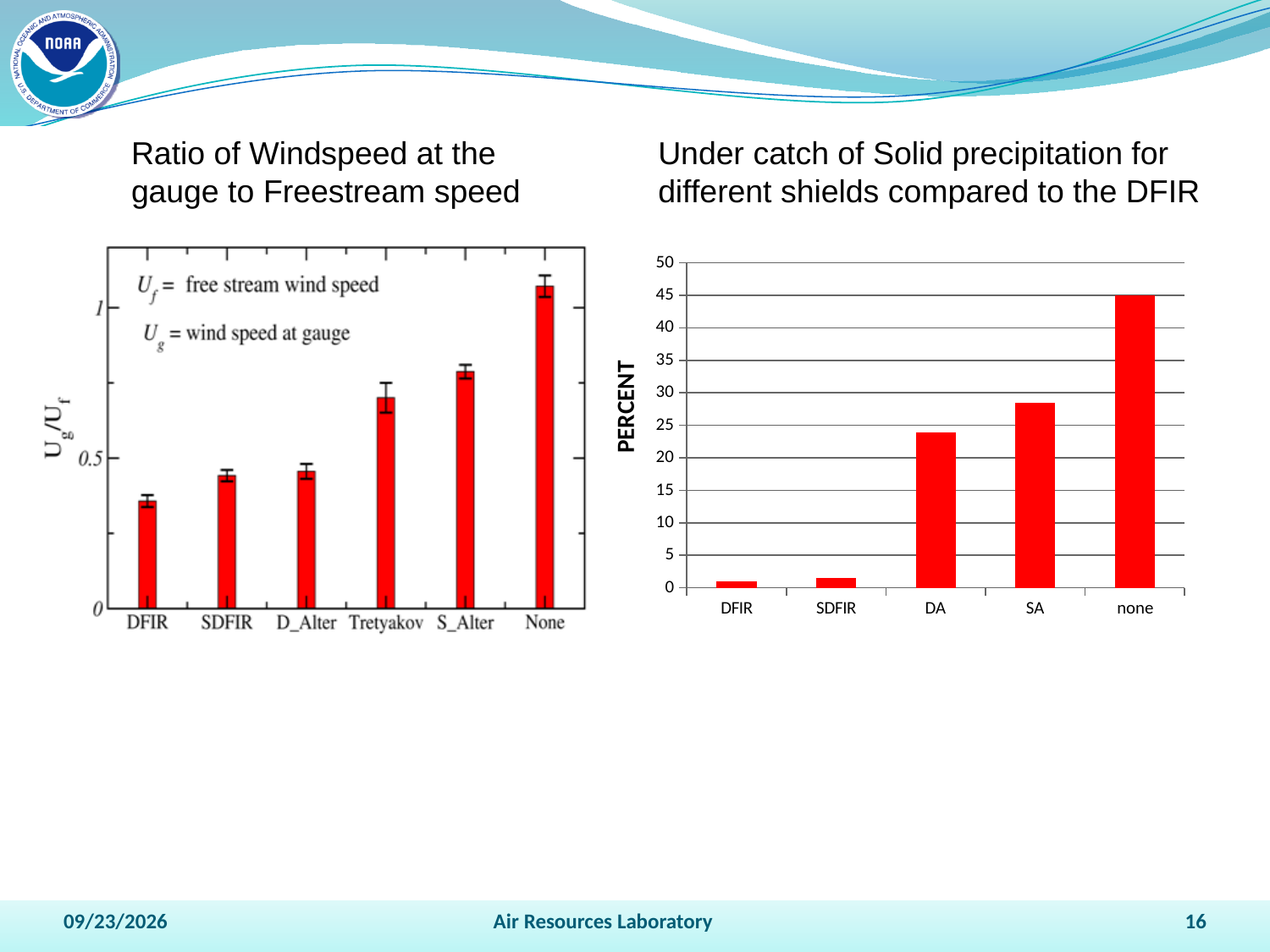
On the chart titled 'Under catch of Solid precipitation for different shields compared to the DFIR', which category has the lowest value? DFIR On the chart titled 'Under catch of Solid precipitation for different shields compared to the DFIR', is the value for SA greater or less than 25? greater On the chart titled 'Ratio of Windspeed at the gauge to Freestream speed', which category has the highest value? None On the chart titled 'Under catch of Solid precipitation for different shields compared to the DFIR', how many categories are shown on the x axis? 5 What kind of chart is the one titled 'Ratio of Windspeed at the gauge to Freestream speed'? bar chart On the chart titled 'Under catch of Solid precipitation for different shields compared to the DFIR', which is larger, the value for SA or the value for DA? SA On the chart titled 'Ratio of Windspeed at the gauge to Freestream speed', which category has the lowest value? DFIR On the chart titled 'Ratio of Windspeed at the gauge to Freestream speed', do the values rise or fall from left to right along the x axis? rise On the chart titled 'Under catch of Solid precipitation for different shields compared to the DFIR', what is the label of the vertical axis? PERCENT On the chart titled 'Ratio of Windspeed at the gauge to Freestream speed', how many categories are shown on the x axis? 6 On the chart titled 'Under catch of Solid precipitation for different shields compared to the DFIR', which category has the highest value? none On the chart titled 'Under catch of Solid precipitation for different shields compared to the DFIR', is the value for DA greater or less than 25? less